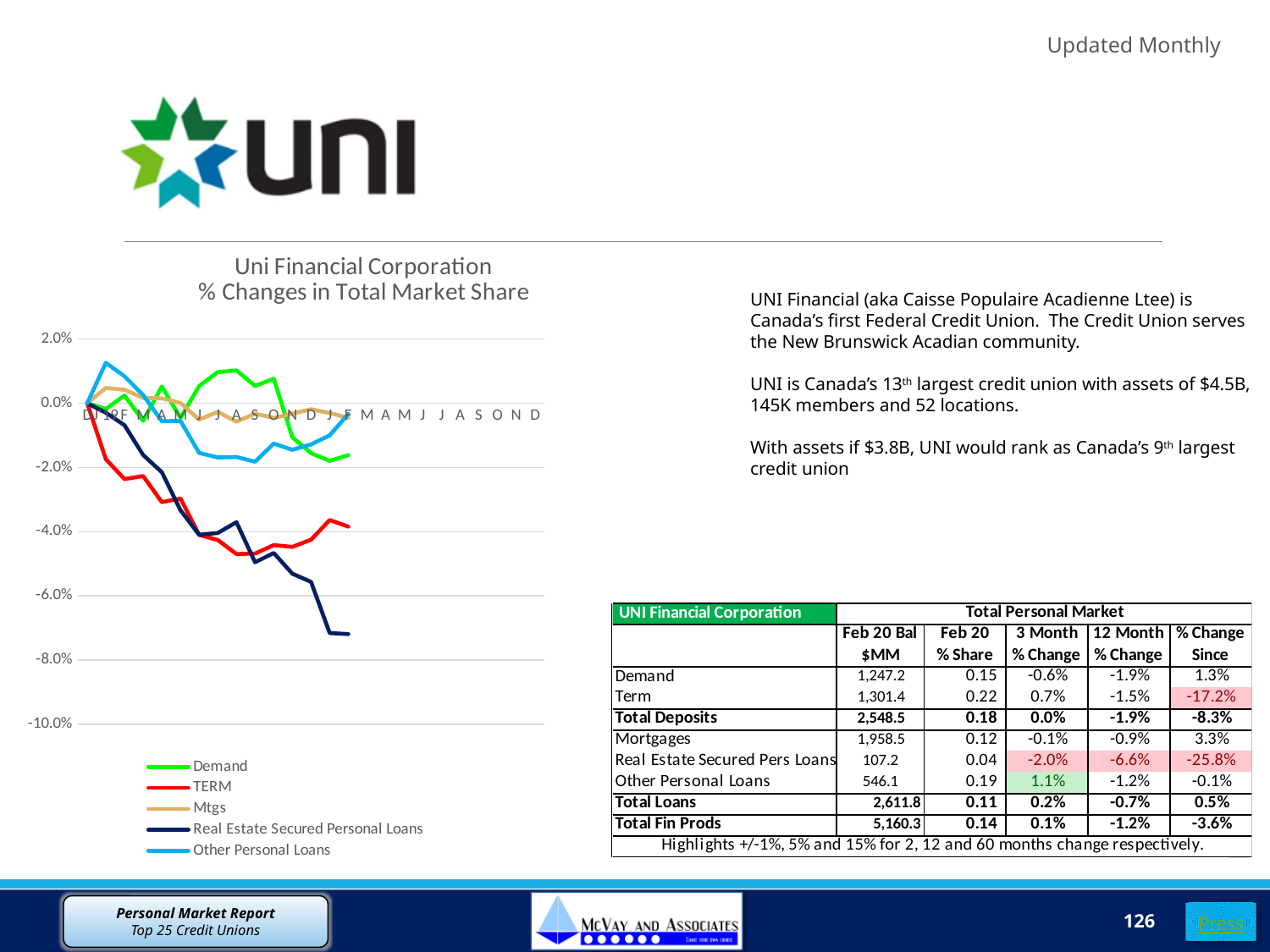
Is the final value of the TERM line greater or less than -2.0%? less Does the TERM line rise or fall overall from the start to the end of the period? fall Is the final value of the Real Estate Secured Personal Loans line greater or less than -6.0%? less What is the title of the chart? Uni Financial Corporation % Changes in Total Market Share What kind of chart is shown on the slide? line chart Is the highest point of the Demand line greater or less than 0.0%? greater Does the Real Estate Secured Personal Loans line rise or fall over the period shown? fall What colour is the Demand line in the chart? green Which series in the chart reaches the lowest value? Real Estate Secured Personal Loans At the end of the period, which is higher: the TERM line or the Real Estate Secured Personal Loans line? TERM How many series does the legend of the chart list? 5